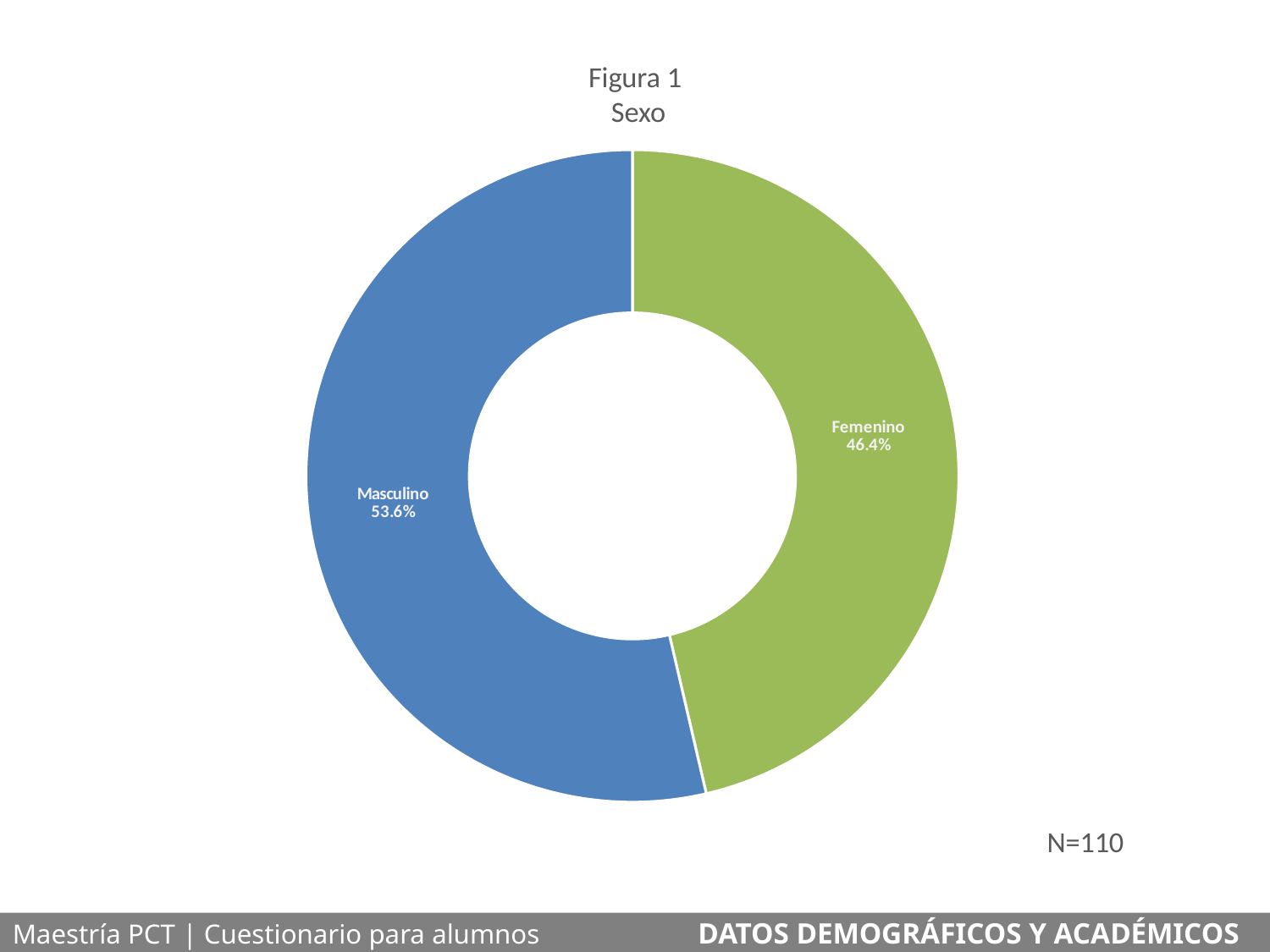
How many categories are shown in the chart? 2 What share of the chart does the Femenino slice represent? 46.4% What percentage is shown for Masculino? 53.6% What colour is the Masculino slice? Blue What is the difference in percentage points between Masculino and Femenino? 7.2 Which category has the largest share of the chart? Masculino Which is larger, the share for Masculino or the share for Femenino? Masculino What percentage is shown for Femenino? 46.4% What is the title of the chart? Figura 1 Sexo What kind of chart is shown on the slide? Doughnut (pie) chart Which category has the smallest share of the chart? Femenino What is the sample size (N) shown on the slide? N=110